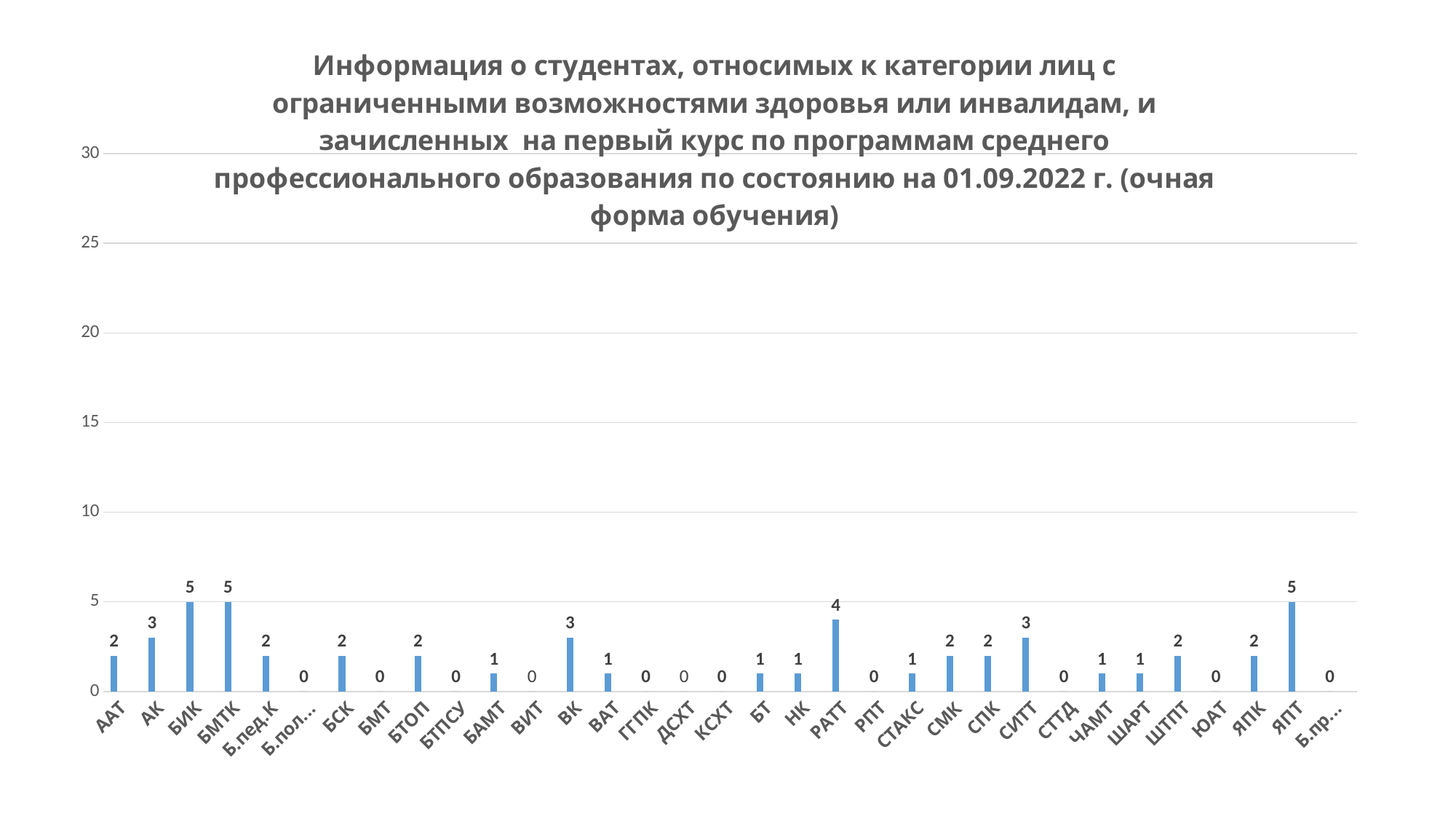
Is the value for РАТТ greater or less than 10? less Which is larger, the value for РАТТ or the value for СИТТ? РАТТ What kind of chart is shown on the slide? bar chart How many categories are shown on the x axis? 33 What is the difference between the values for РАТТ and АК? 1 What is the value for СИТТ? 3 What is the value for ЮАТ? 0 What is the value for ВК? 3 Which categories share the highest value on the chart? БИК, БМТК, ЯПТ What is the value for РАТТ? 4 What is the difference between the values for ЯПТ and ВК? 2 What is the value for ШТПТ? 2